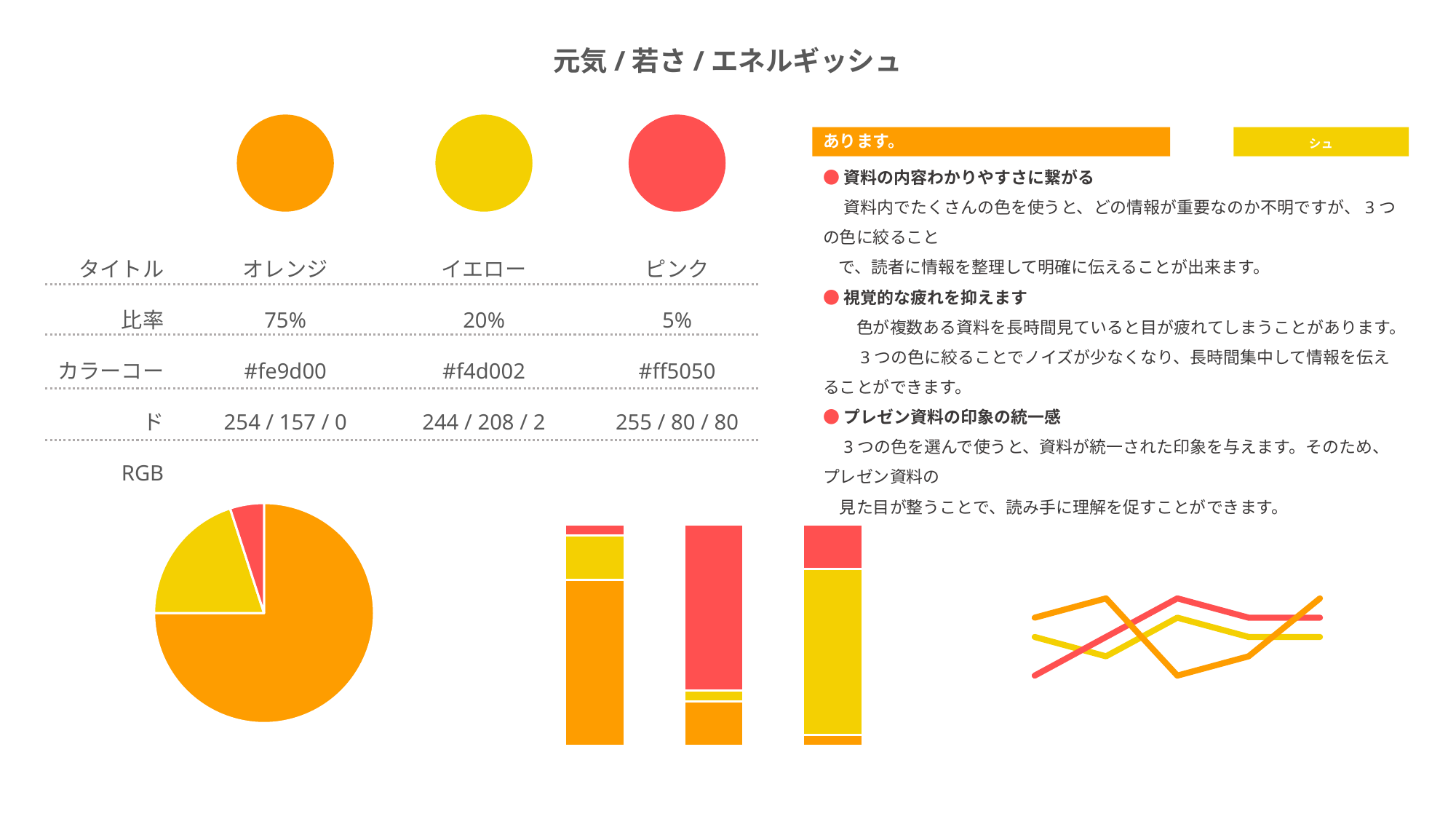
In the pie chart at the bottom left, which colour has the smallest slice? pink What kind of chart is shown at the bottom right of the slide? line chart How many stacked bars are in the bar chart at the bottom centre? 3 In the pie chart at the bottom left, which colour has the largest slice? orange How many slices does the pie chart at the bottom left have? 3 What kind of chart is shown at the bottom centre of the slide, with the three stacked columns? bar chart How many lines are plotted in the line chart at the bottom right? 3 In the bar chart at the bottom centre, which colour takes up the largest part of the middle bar? pink In the bar chart at the bottom centre, which colour takes up the largest part of the right-hand bar? yellow In the pie chart at the bottom left, is the yellow slice larger or smaller than the pink slice? larger What kind of chart is shown at the bottom left of the slide? pie chart According to the slide, what share of the pie chart does the orange slice represent? 75%